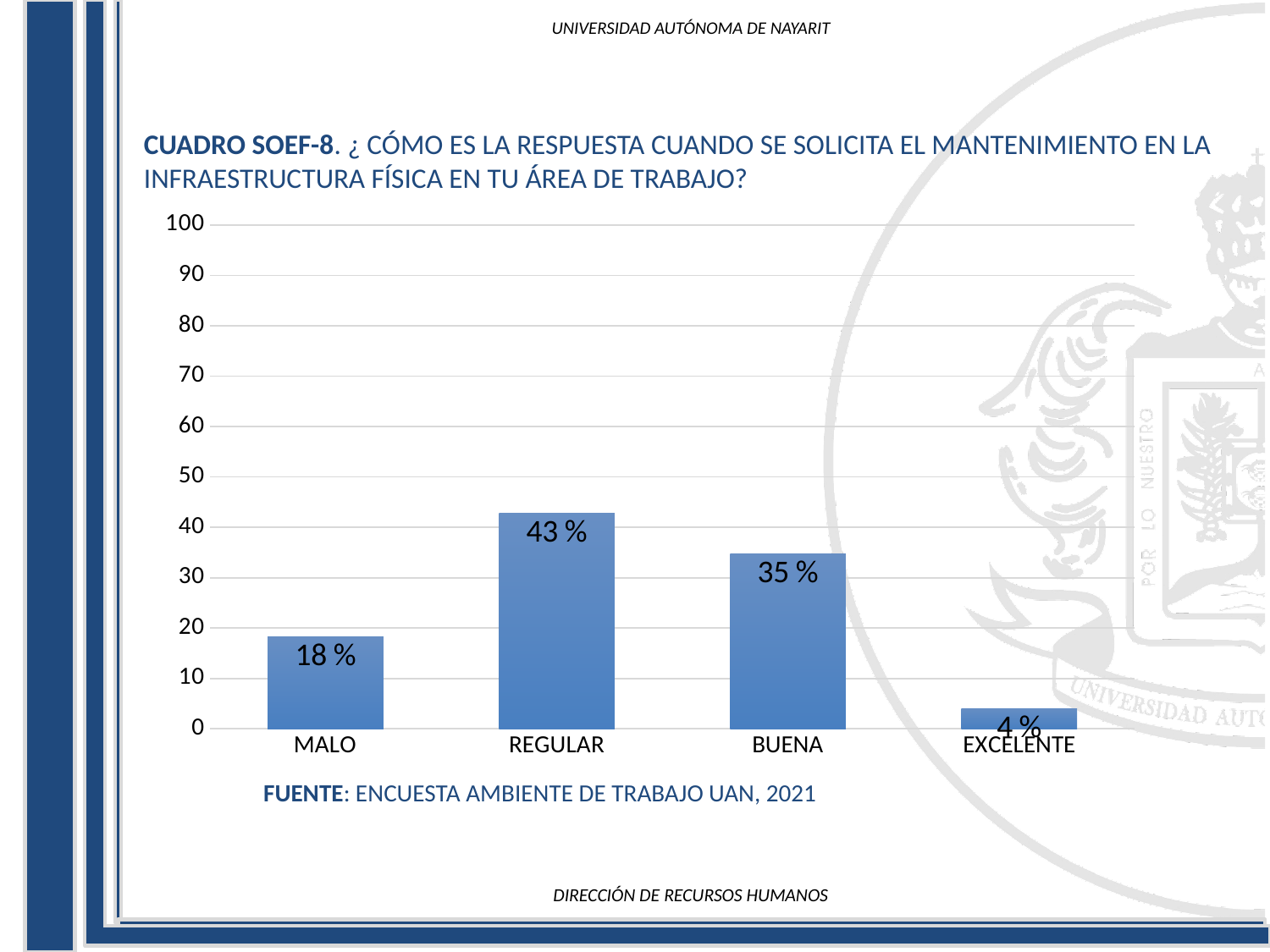
Is the value for REGULAR greater or less than 40? greater Which is larger, the value for MALO or the value for BUENA? BUENA Which category has the lowest value? EXCELENTE How many categories are shown on the x axis? 4 What is the value for BUENA? 35 % What kind of chart is shown on the slide? bar chart What is the value for EXCELENTE? 4 % Which category has the highest value? REGULAR What is the difference between the values for REGULAR and BUENA? 8 % What is the value for MALO? 18 % What source is cited below the chart? ENCUESTA AMBIENTE DE TRABAJO UAN, 2021 What is the value for REGULAR? 43 %